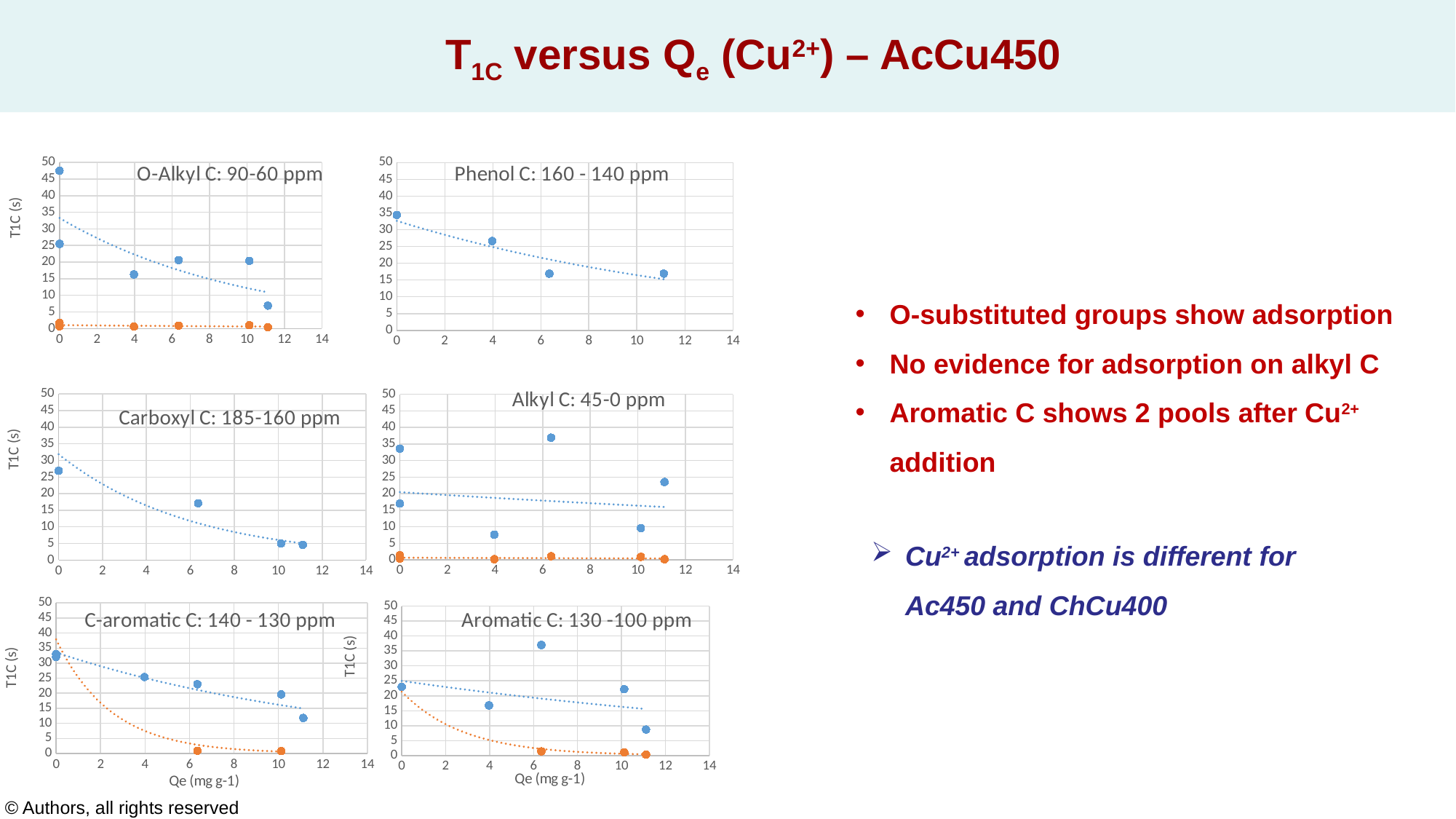
How many blue data points are plotted in the 'Phenol C: 160 - 140 ppm' chart? 4 In the 'Phenol C: 160 - 140 ppm' chart, is the value of the blue point at Qe = 0 greater or less than 30? greater In the 'Carboxyl C: 185-160 ppm' chart, do the blue points rise or fall as Qe increases? fall How many charts are shown on the slide? 6 What is the y-axis label on the 'Carboxyl C: 185-160 ppm' chart? T1C (s) In the 'O-Alkyl C: 90-60 ppm' chart, is the highest blue point greater or less than 45? greater In the 'Aromatic C: 130 -100 ppm' chart, is the highest blue point greater or less than 35? greater What kind of chart is the 'Phenol C: 160 - 140 ppm' chart? scatter chart In the 'Phenol C: 160 - 140 ppm' chart, which blue point is larger: the one at Qe = 0 or the one at Qe = 4? Qe = 0 In the 'Phenol C: 160 - 140 ppm' chart, do the blue points rise or fall as Qe increases? fall